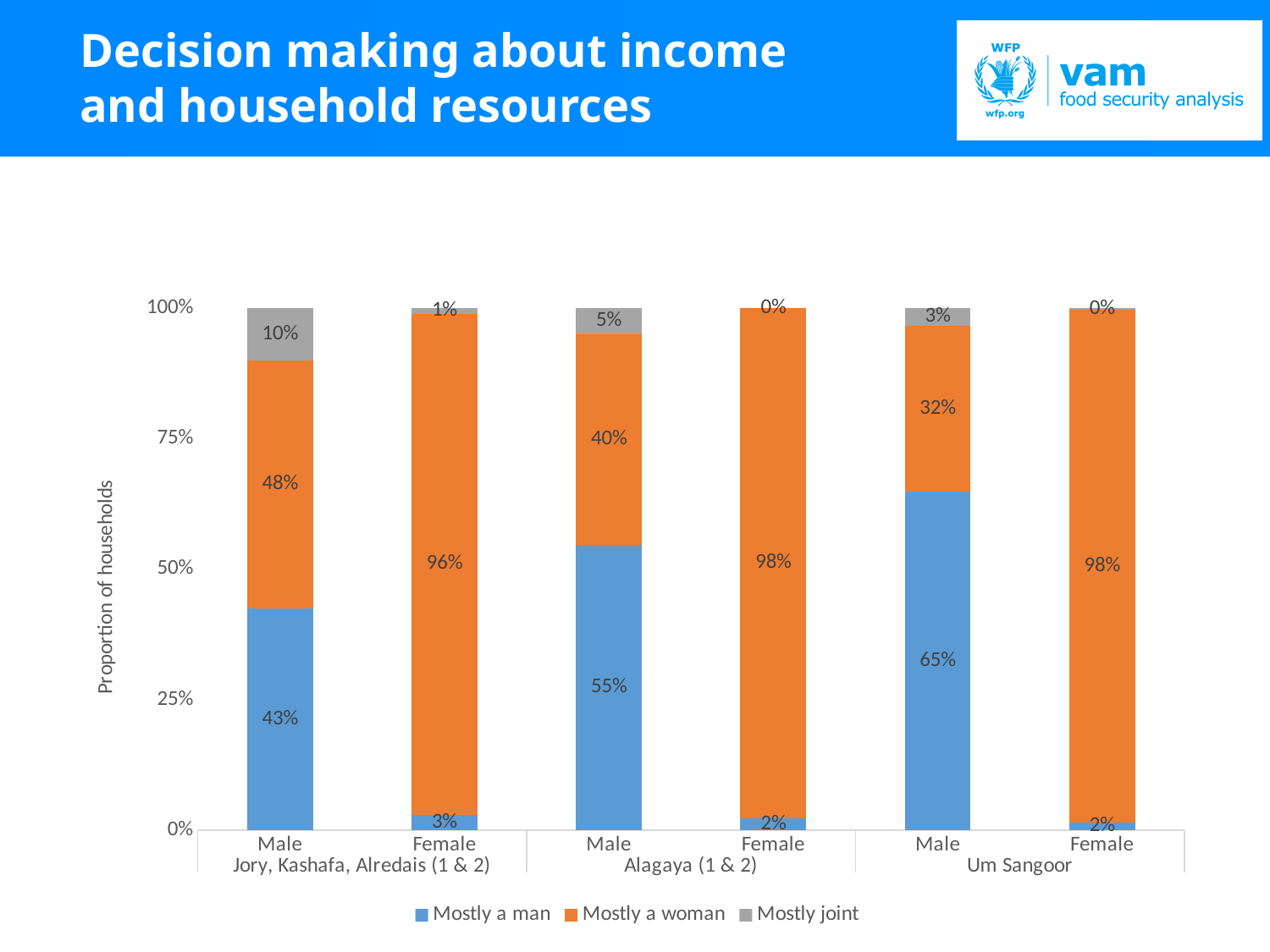
What type of chart is shown on the slide? Stacked bar chart What percentage of male respondents in Um Sangoor report that decisions are made mostly by a man? 65% Among the male bars, which location has the highest 'Mostly a man' share? Um Sangoor For male respondents in Jory, Kashafa, Alredais (1 & 2), which is larger: 'Mostly a man' or 'Mostly a woman'? Mostly a woman What is the 'Mostly a woman' value for female respondents in Alagaya (1 & 2)? 98% What is the difference between the 'Mostly a man' values for male respondents in Um Sangoor and in Alagaya (1 & 2)? 10% What is the label on the vertical axis of the chart? Proportion of households What is the 'Mostly joint' value for male respondents in Jory, Kashafa, Alredais (1 & 2)? 10% What is the 'Mostly a man' value for female respondents in Jory, Kashafa, Alredais (1 & 2)? 3% Among the male bars, which location has the lowest 'Mostly joint' share? Um Sangoor How many bars are plotted in the chart? 6 How many series does the legend list? 3